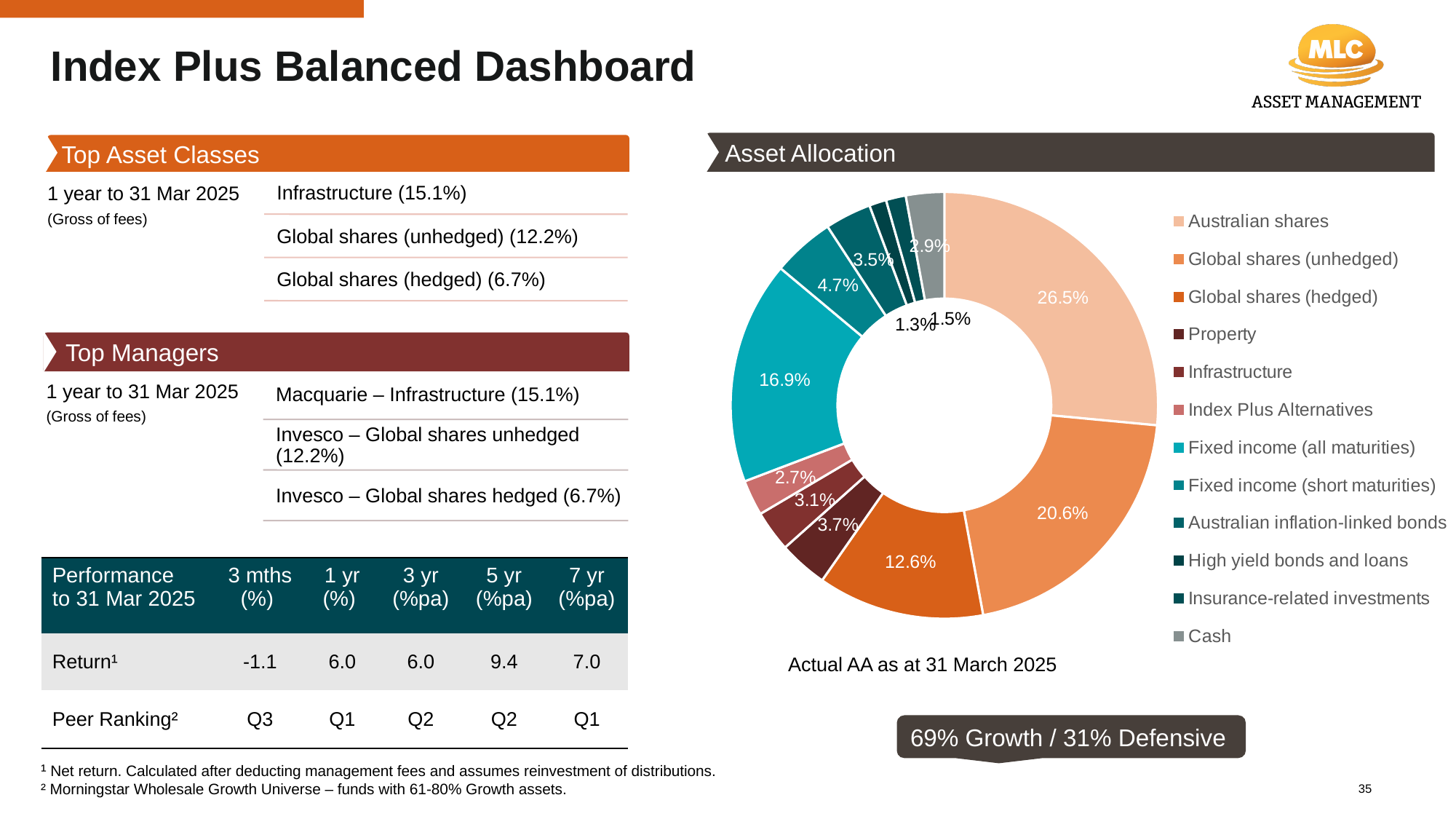
In the Asset Allocation chart, what percentage is allocated to Fixed income (all maturities)? 16.9% In the Asset Allocation chart, what percentage is allocated to Cash? 2.9% What date is the Asset Allocation chart stated to be as at? 31 March 2025 In the Asset Allocation chart, what percentage is allocated to Australian shares? 26.5% Which asset class has the largest share in the Asset Allocation chart? Australian shares In the Asset Allocation chart, how many percentage points larger is the Australian shares slice than the Global shares (unhedged) slice? 5.9 In the Asset Allocation chart, what percentage is allocated to Global shares (hedged)? 12.6% In the Asset Allocation chart, which is larger: Fixed income (all maturities) or Global shares (hedged)? Fixed income (all maturities) What kind of chart is shown under the Asset Allocation heading? Pie chart (donut) How many asset classes are listed in the legend of the Asset Allocation chart? 12 In the Asset Allocation chart, what percentage is allocated to Global shares (unhedged)? 20.6% In the Asset Allocation chart, what percentage is allocated to Property? 3.7%